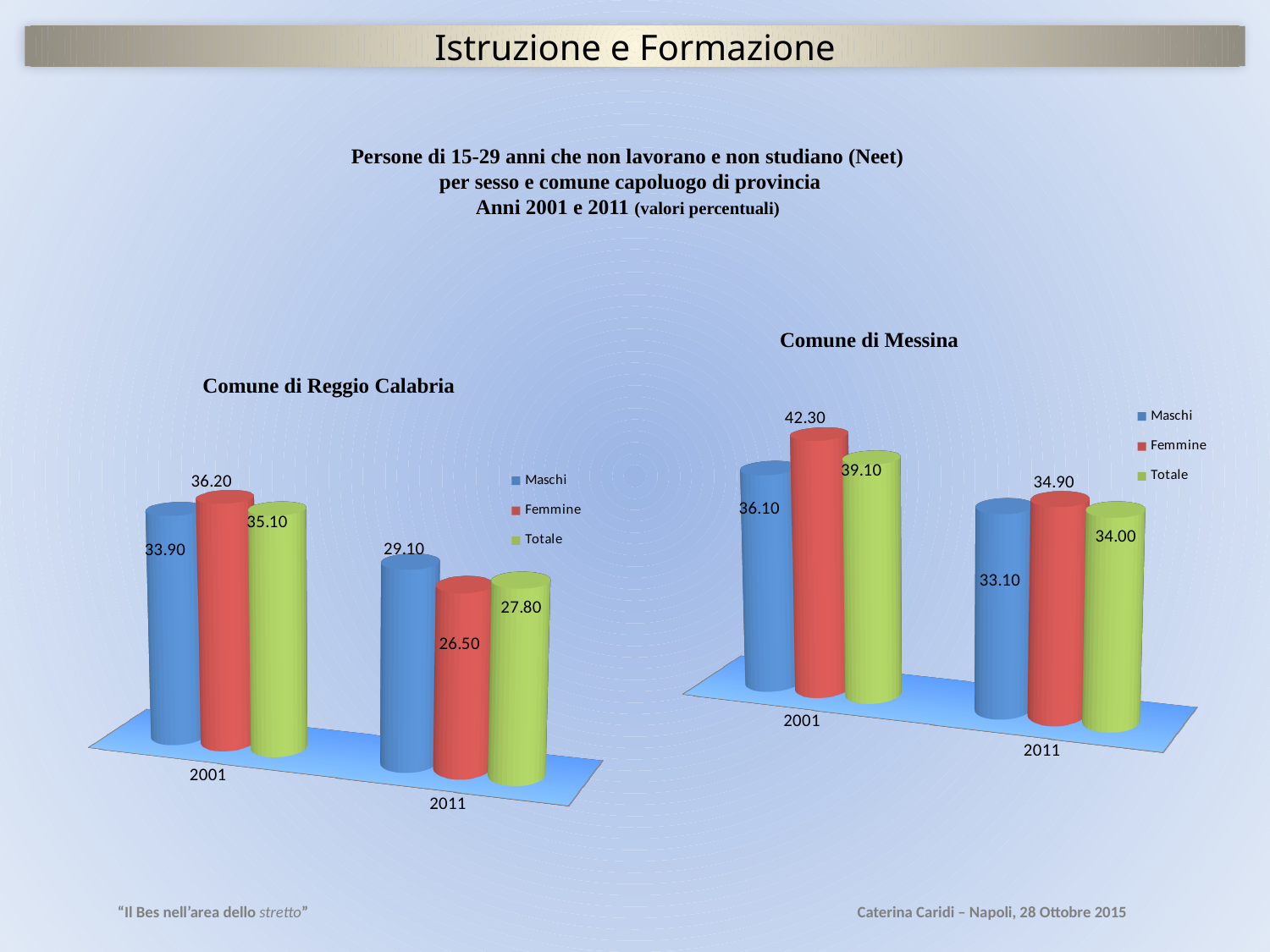
In the 'Comune di Reggio Calabria' chart, which series has the lowest value in 2011? Femmine In the 'Comune di Messina' chart, what is the value for Femmine in 2001? 42.30 In the 'Comune di Messina' chart, what is the value for Totale in 2011? 34.00 In the 'Comune di Reggio Calabria' chart, what is the value for Femmine in 2001? 36.20 In the 'Comune di Reggio Calabria' chart, what is the value for Maschi in 2011? 29.10 What kind of chart is the 'Comune di Messina' chart? Bar chart In the 'Comune di Reggio Calabria' chart, do the Totale values rise or fall from 2001 to 2011? Fall In the 'Comune di Reggio Calabria' chart, what is the difference between the Totale values for 2001 and 2011? 7.30 In the 'Comune di Messina' chart, what is the difference between the Femmine values for 2001 and 2011? 7.40 How many series does the legend of the 'Comune di Reggio Calabria' chart list? 3 In the 'Comune di Messina' chart, which is larger: Maschi in 2001 or Maschi in 2011? Maschi in 2001 In the 'Comune di Messina' chart, which series has the highest value in 2001? Femmine